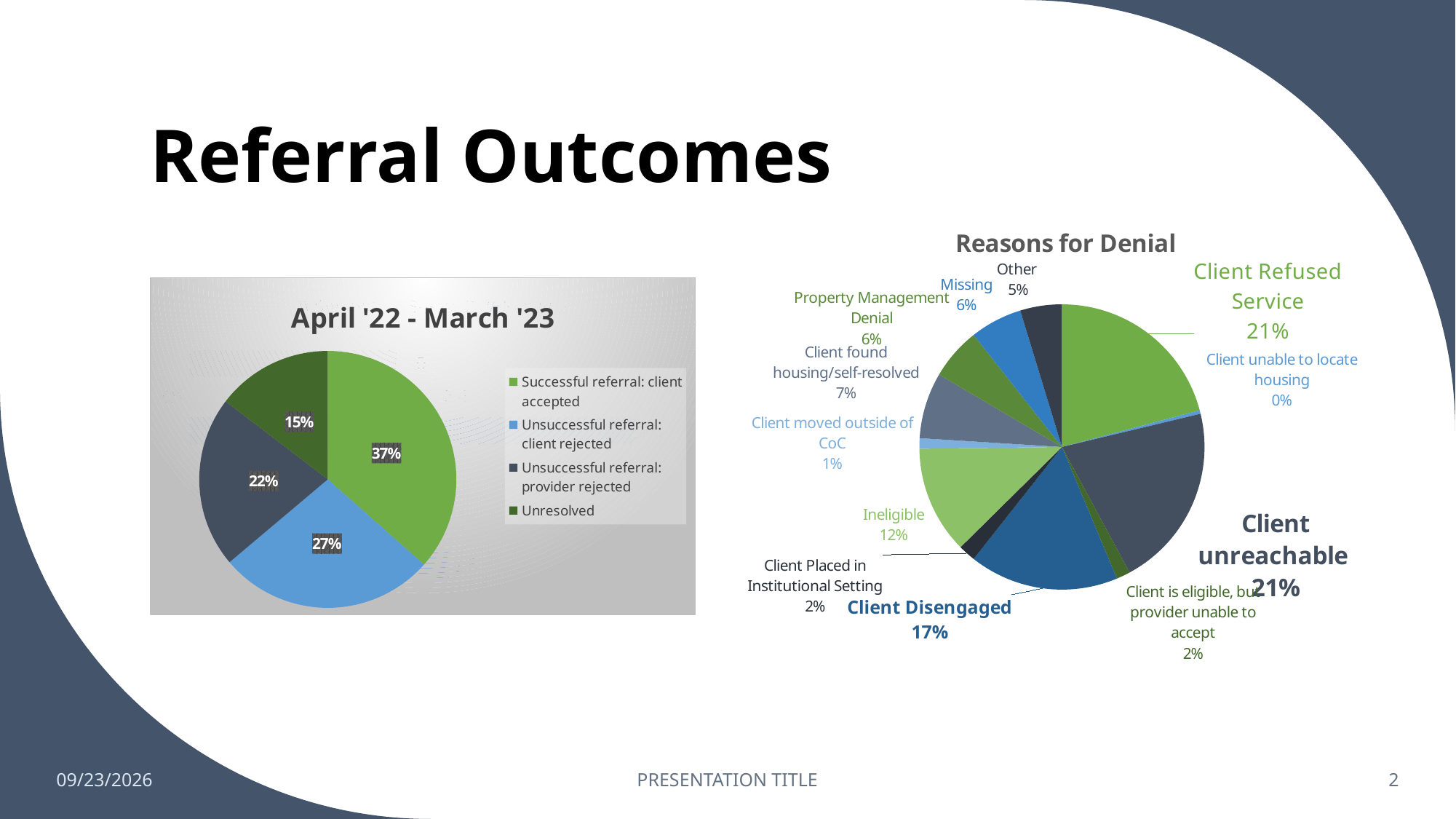
How many slices are labelled in the 'Reasons for Denial' chart? 12 In the 'Reasons for Denial' chart, what percentage is shown for 'Client Disengaged'? 17% In the 'April '22 - March '23' chart, what share of referrals were successful (client accepted)? 37% In the 'April '22 - March '23' chart, which category has the largest share? Successful referral: client accepted In the 'Reasons for Denial' chart, what percentage is shown for 'Ineligible'? 12% In the 'Reasons for Denial' chart, which reason has the smallest share? Client unable to locate housing In the 'Reasons for Denial' chart, what is the difference between 'Client Refused Service' and 'Client Disengaged'? 4% What type of chart is the 'April '22 - March '23' chart? Pie chart In the 'April '22 - March '23' chart, what is the difference between the 'Unsuccessful referral: client rejected' share and the 'Unsuccessful referral: provider rejected' share? 5% In the 'Reasons for Denial' chart, which is larger: 'Client found housing/self-resolved' or 'Other'? Client found housing/self-resolved In the 'April '22 - March '23' chart, what percentage is shown for 'Unresolved'? 15% In the 'April '22 - March '23' chart, how many categories does the legend list? 4